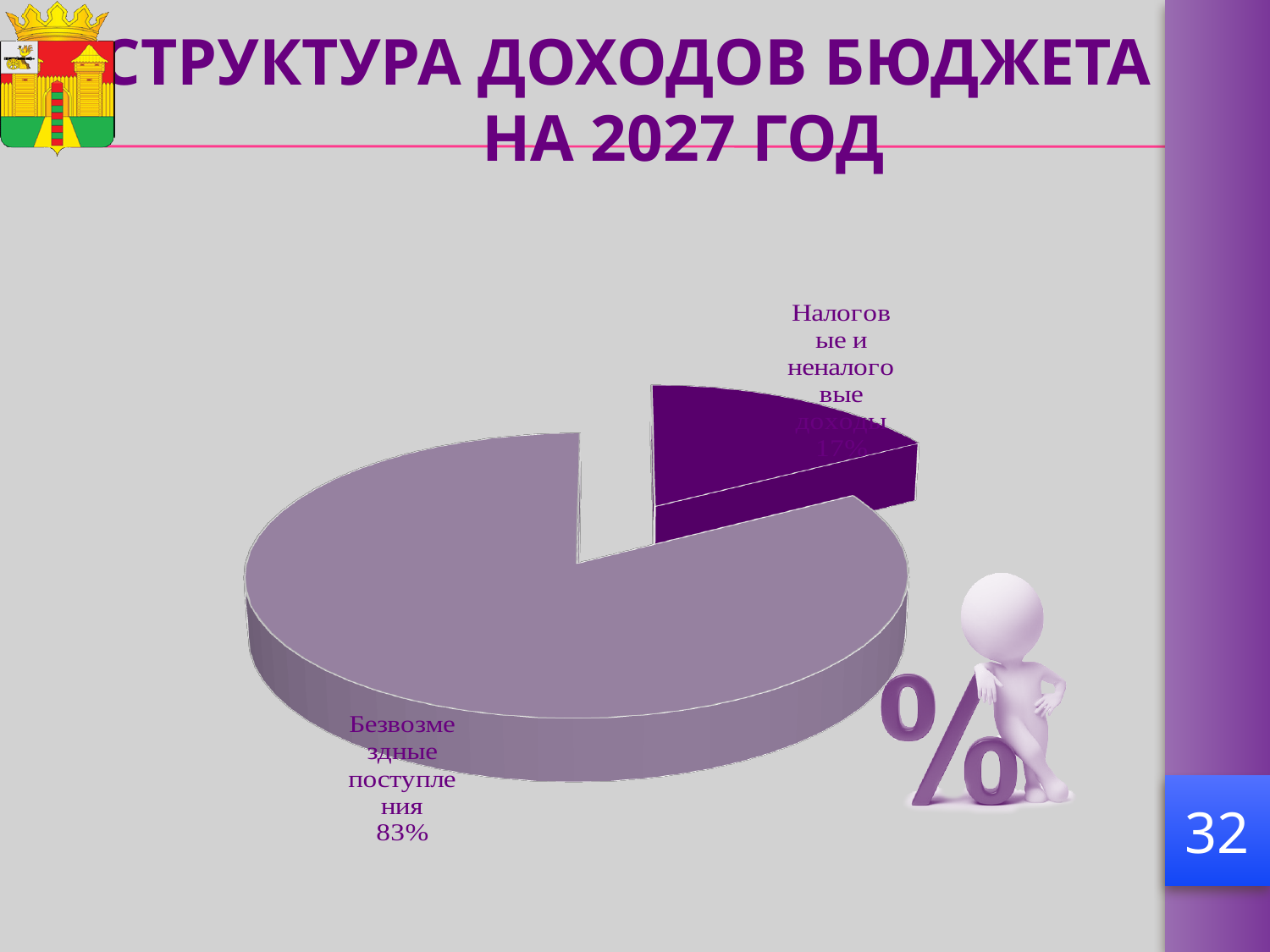
Is the share for "Налоговые и неналоговые доходы" greater or less than 50%? less Which slice of the pie chart is the smallest? Налоговые и неналоговые доходы What kind of chart is shown on the slide? pie chart Is the share for "Безвозмездные поступления" greater or less than 50%? greater What share of the pie is labelled "Безвозмездные поступления"? 83% What is the title of the chart on the slide? СТРУКТУРА ДОХОДОВ БЮДЖЕТА НА 2027 ГОД How many slices does the pie chart have? 2 Which is larger: the slice for "Безвозмездные поступления" or the slice for "Налоговые и неналоговые доходы"? Безвозмездные поступления Which slice of the pie chart is the largest? Безвозмездные поступления Which slice of the pie chart is pulled out (exploded) from the rest of the pie? Налоговые и неналоговые доходы